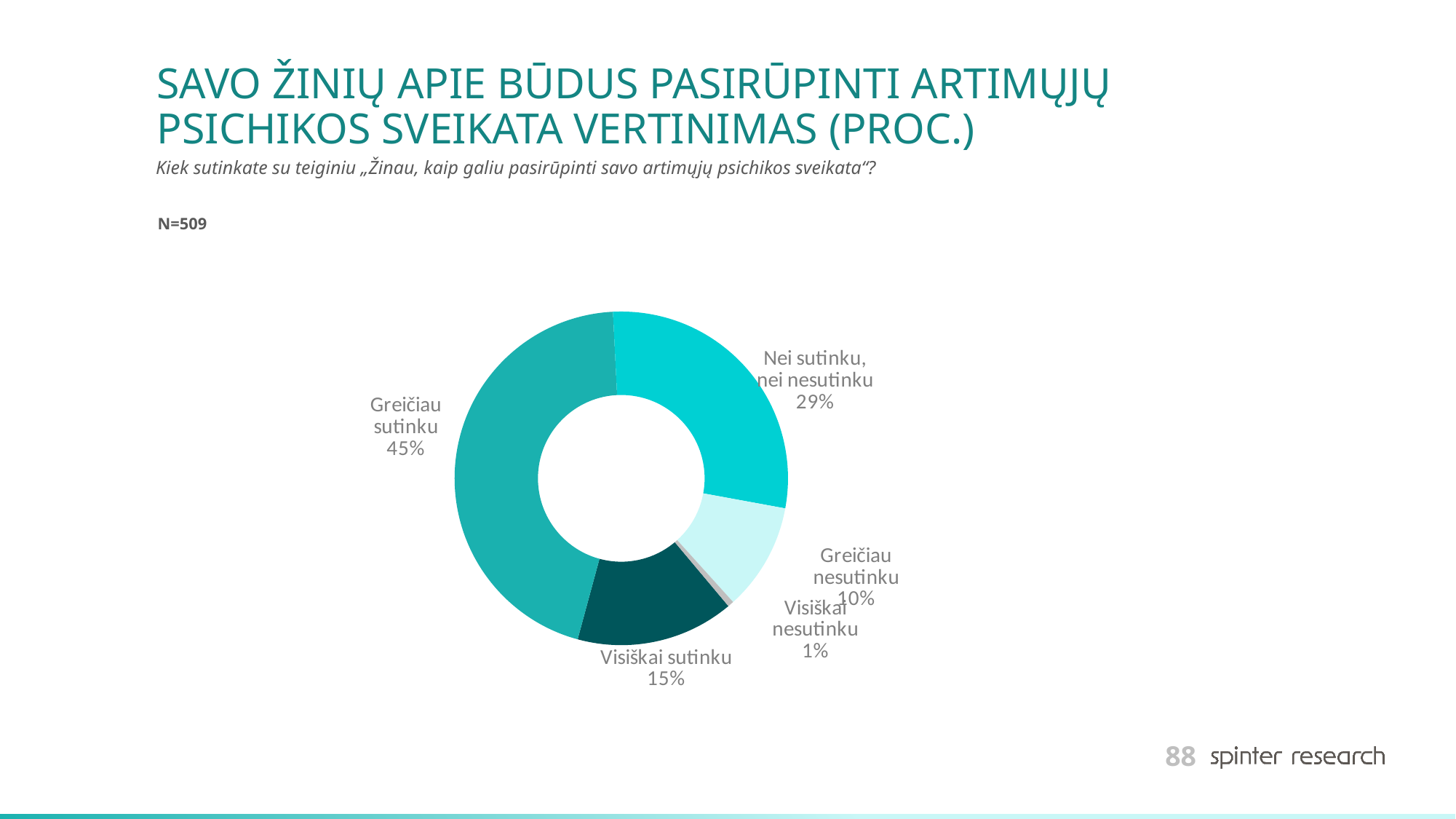
What percentage of respondents answered "Greičiau sutinku"? 45% What percentage of respondents answered "Greičiau nesutinku"? 10% What percentage of respondents answered "Visiškai nesutinku"? 1% Which is larger: the share for "Visiškai sutinku" or the share for "Greičiau nesutinku"? Visiškai sutinku What percentage of respondents answered "Visiškai sutinku"? 15% What type of chart is shown on the slide? Pie chart (doughnut) How many response categories are shown in the chart? 5 What is the sample size (N) stated on the slide? N=509 What is the difference in percentage points between "Greičiau sutinku" and "Nei sutinku, nei nesutinku"? 16 Which response category has the largest share of the pie? Greičiau sutinku Which response category has the smallest share of the pie? Visiškai nesutinku What percentage of respondents answered "Nei sutinku, nei nesutinku"? 29%